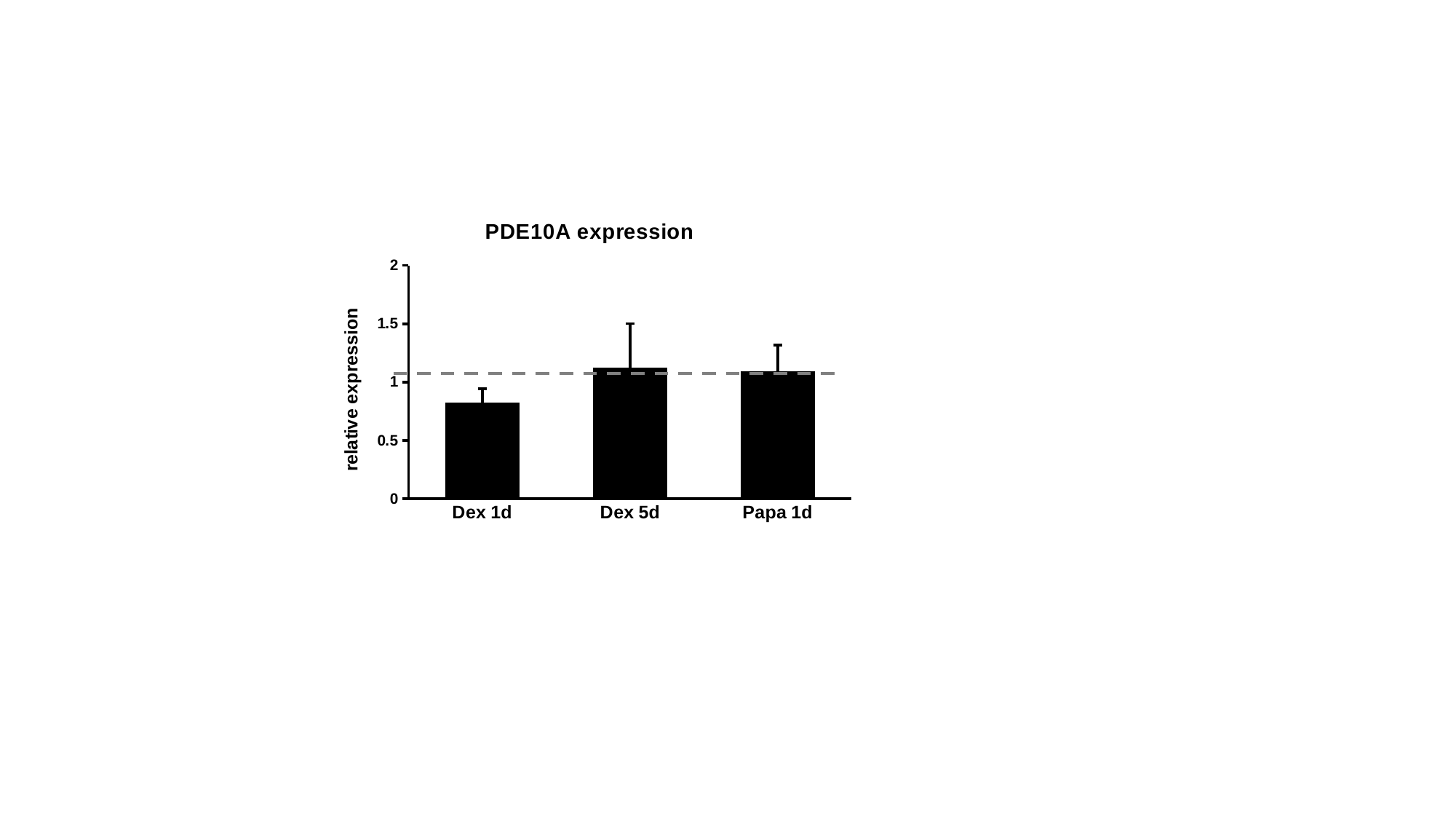
What is the title of the chart? PDE10A expression Is the value for Papa 1d greater or less than 0.5? greater Which category has the lowest relative expression? Dex 1d How many categories are plotted on the x axis? 3 Is the value for Dex 5d greater or less than 1.5? less Is the value for Dex 5d greater or less than 1? greater Which is larger, the value for Dex 1d or the value for Papa 1d? Papa 1d Which is larger, the value for Dex 1d or the value for Dex 5d? Dex 5d What is the label of the y axis? relative expression What kind of chart is shown on the slide? bar chart